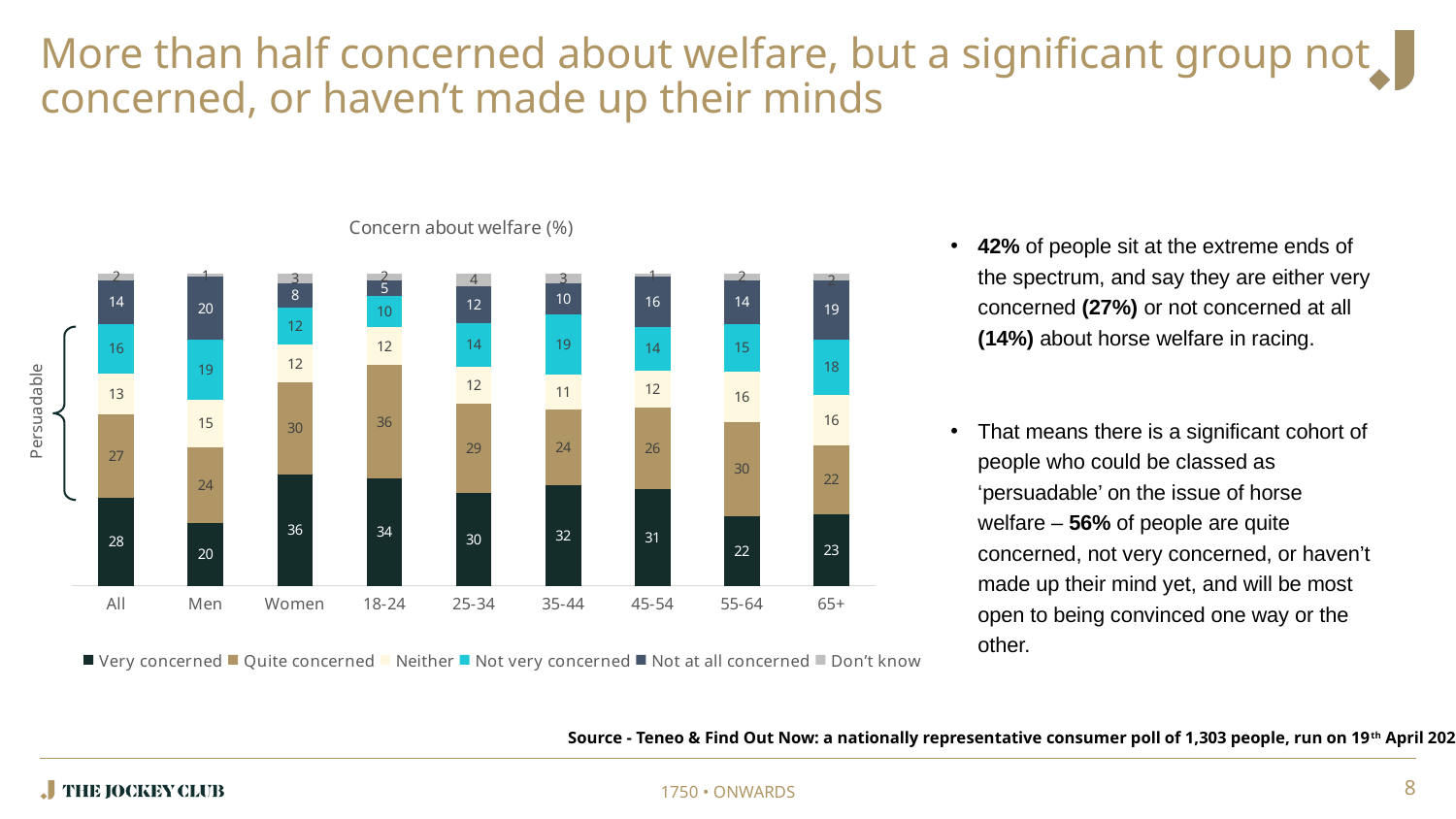
What is the title of the chart? Concern about welfare (%) What kind of chart is this? Stacked bar chart What is the value for Quite concerned in the 18-24 category? 36 How many categories are shown on the x axis? 9 What is the value for Not at all concerned in the Men category? 20 What is the difference between the Very concerned values for Women and Men? 16 Which is larger, the Not at all concerned value for 65+ or for 55-64? 65+ What is the value for Not very concerned in the 65+ category? 18 Which category has the highest value for Very concerned? Women How many series does the legend list? 6 What is the value for Very concerned in the All category? 28 Which category has the lowest value for Very concerned? Men